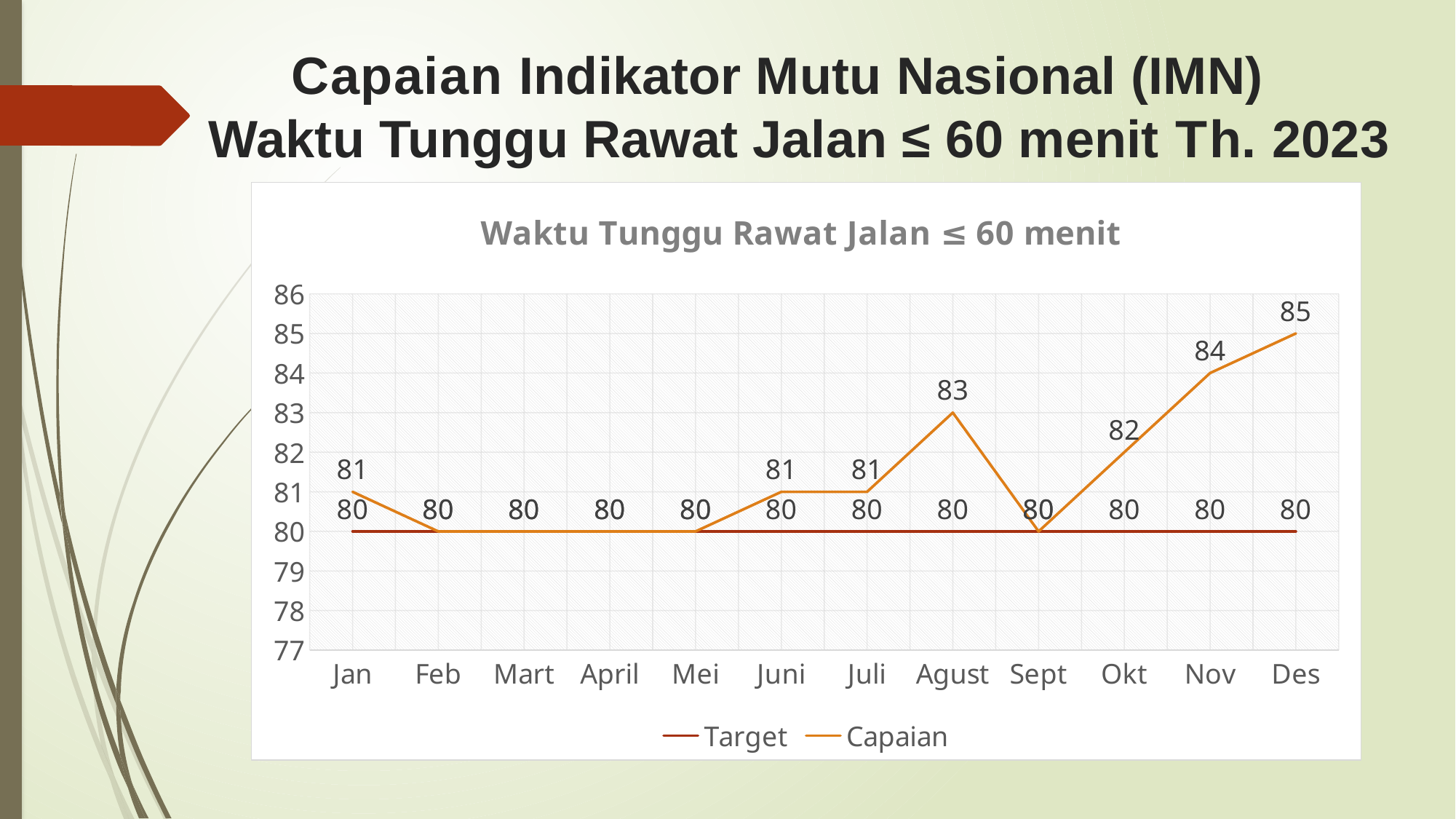
What is the Target value for Juni? 80 What is the difference between the Capaian value for Nov and the Target value for Nov? 4 What is the Capaian value for Agust? 83 What is the difference between the Capaian values for Agust and Sept? 3 What is the Capaian value for Des? 85 What type of chart is shown on the slide? line chart In which month is the Capaian value highest? Des How many series does the legend list? 2 Does the Capaian value rise or fall from Sept to Des? rise What is the title of the chart? Waktu Tunggu Rawat Jalan ≤ 60 menit Which is larger, the Capaian value for Okt or the Capaian value for Juli? Okt How many months are shown on the x axis? 12